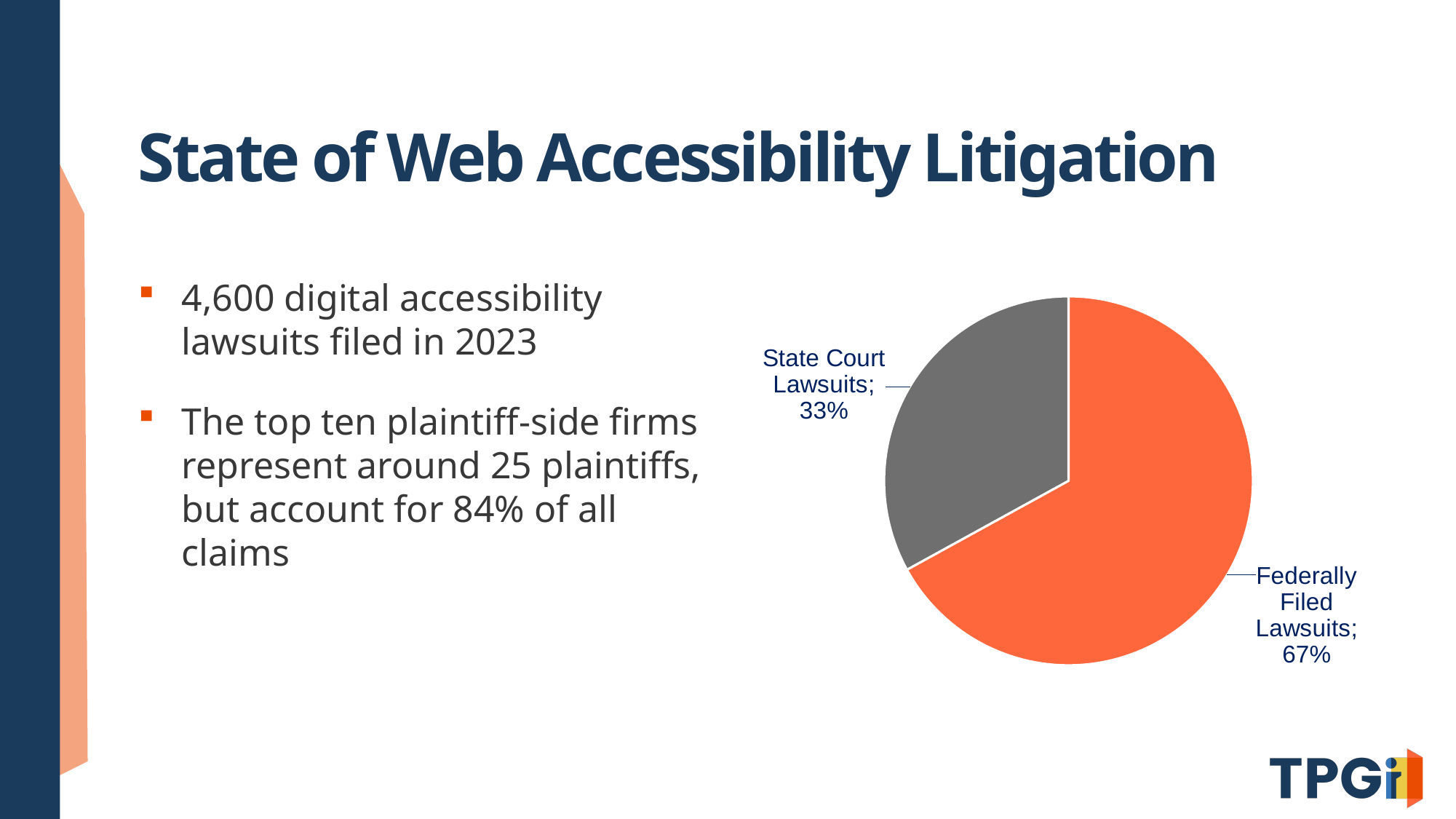
Which is larger, the share for State Court Lawsuits or the share for Federally Filed Lawsuits? Federally Filed Lawsuits What kind of chart is shown on the slide? Pie chart What colour is the State Court Lawsuits slice? Grey How many slices does the pie chart have? 2 What share of the pie is Federally Filed Lawsuits? 67% What colour is the Federally Filed Lawsuits slice? Orange Which slice of the pie is the largest? Federally Filed Lawsuits Which slice of the pie is the smallest? State Court Lawsuits What is the difference in percentage points between Federally Filed Lawsuits and State Court Lawsuits? 34 What share of the pie is State Court Lawsuits? 33%